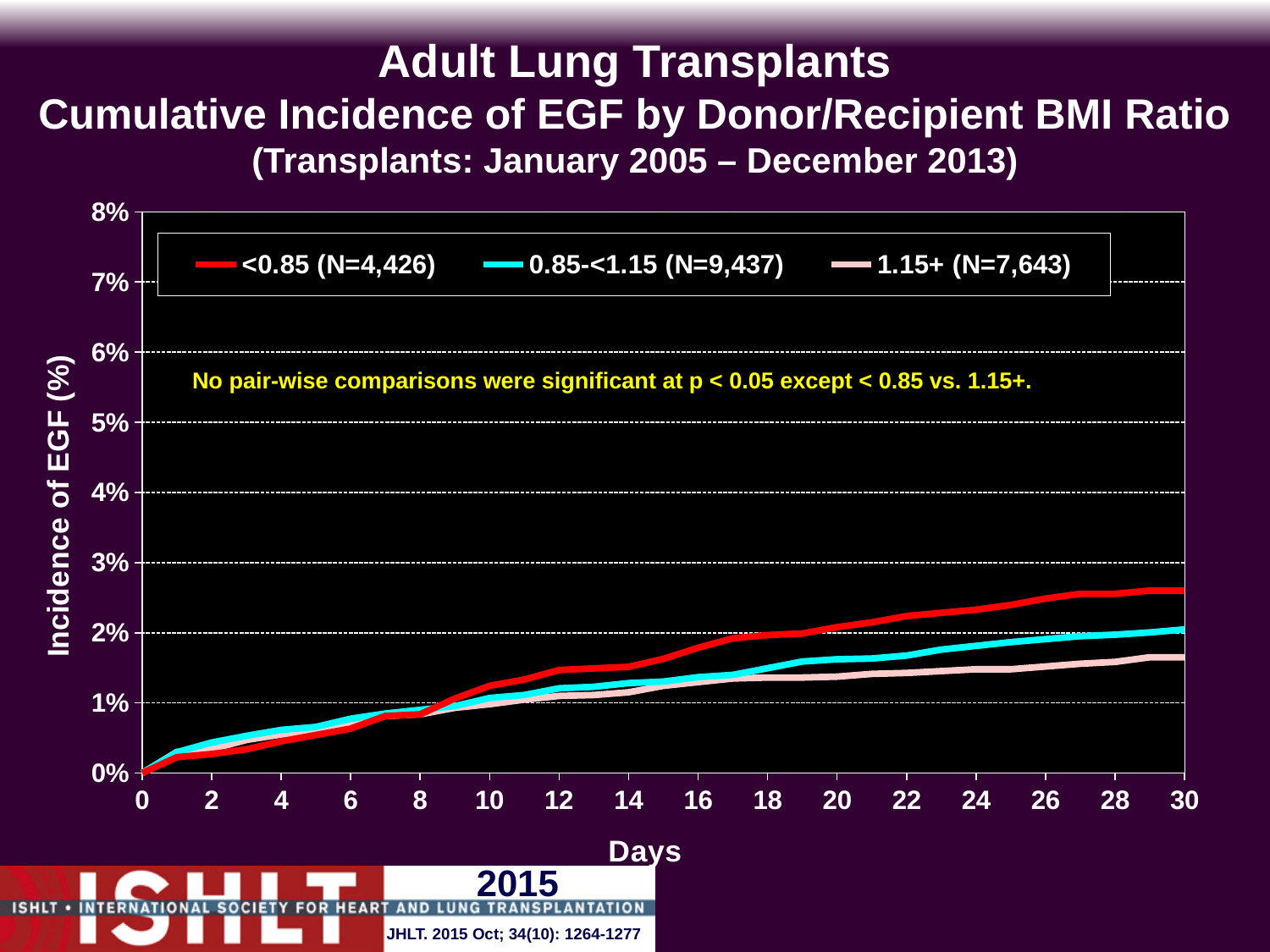
Is the value for the <0.85 series at day 30 greater or less than 2%? greater Is the value for the 1.15+ series at day 30 greater or less than 2%? less Do the values for the <0.85 series rise or fall as the number of days increases? rise At day 30, which is larger: the value for the <0.85 series or the value for the 1.15+ series? <0.85 What kind of chart is shown on the slide? line chart Is the value for the <0.85 series at day 30 greater or less than 3%? less What is the label of the y axis? Incidence of EGF (%) Which series has the highest cumulative incidence of EGF at day 30? <0.85 (N=4,426) What is the number of transplants (N) shown in the legend for the 0.85-<1.15 series? 9,437 How many series does the legend list? 3 Which series has the lowest cumulative incidence of EGF at day 30? 1.15+ (N=7,643)